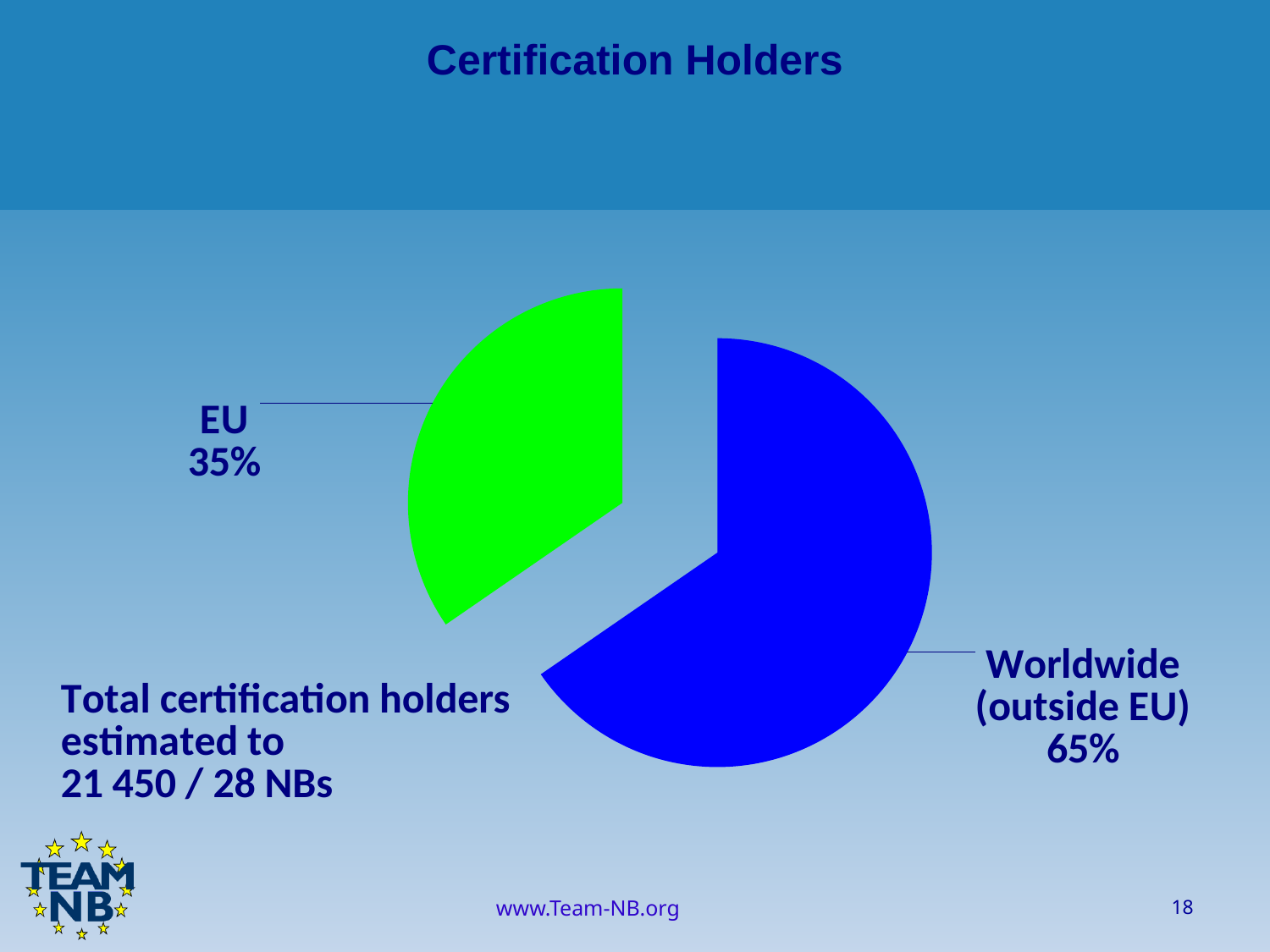
What share of certification holders is Worldwide (outside EU)? 65% Which slice of the pie is the largest? Worldwide (outside EU) Which is larger, the EU share or the Worldwide (outside EU) share? Worldwide (outside EU) What is the difference in percentage points between the Worldwide (outside EU) share and the EU share? 30 How many slices does the pie chart have? 2 Which slice of the pie is the smallest? EU What is the total number of certification holders estimated to be, according to the slide? 21 450 / 28 NBs What kind of chart is shown on the slide? Pie chart Is the EU share greater or less than 50%? less What share of certification holders is from the EU? 35% What is the title of the slide containing the chart? Certification Holders What colour is the EU slice of the pie? Green